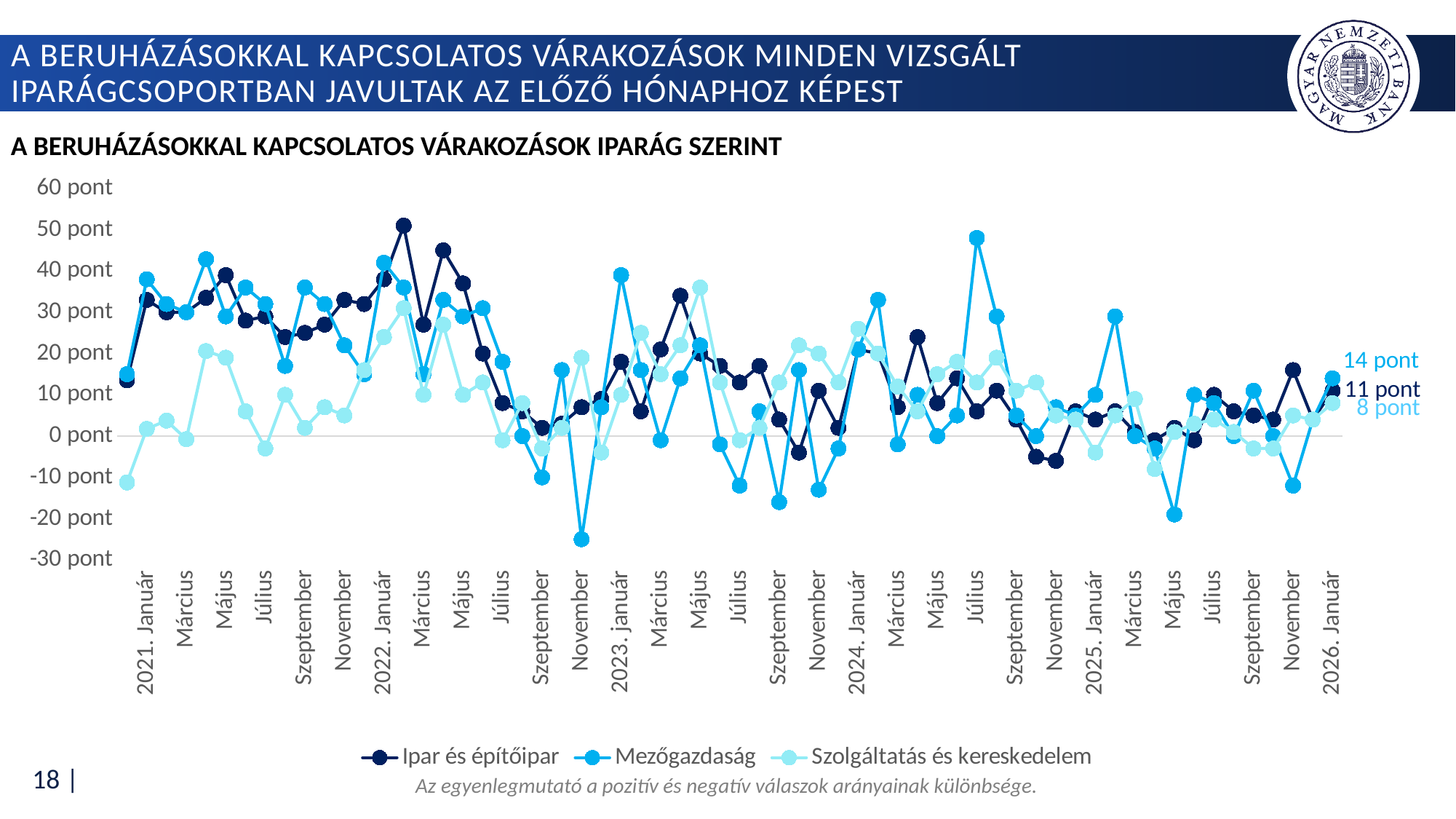
In 2026. Január, which is larger: the value for Ipar és építőipar or for Szolgáltatás és kereskedelem? Ipar és építőipar What is the difference between the Mezőgazdaság and Szolgáltatás és kereskedelem values in 2026. Január? 6 pont What is the value for Mezőgazdaság in 2026. Január? 14 pont What is the value for Szolgáltatás és kereskedelem in 2026. Január? 8 pont How many series does the legend list? 3 Which series has the lowest value in 2026. Január? Szolgáltatás és kereskedelem What kind of chart is shown on the slide? line chart What is the value for Ipar és építőipar in 2026. Január? 11 pont Which series has the highest value in 2026. Január? Mezőgazdaság Is the value for Mezőgazdaság in Július 2024 greater or less than 40 pont? greater What is the difference between the Mezőgazdaság and Ipar és építőipar values in 2026. Január? 3 pont